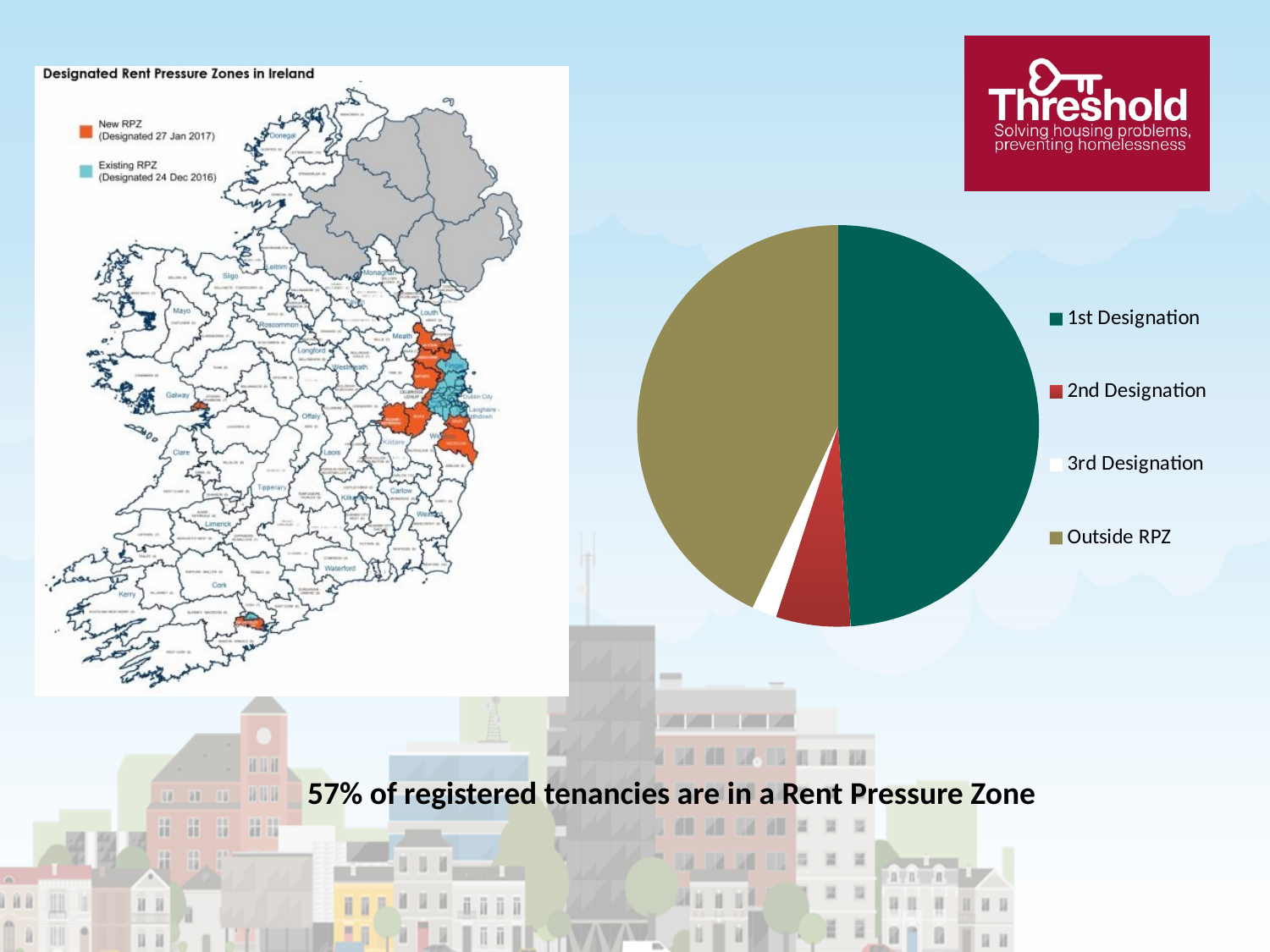
In the pie chart, which is larger: 1st Designation or 2nd Designation? 1st Designation How many slices does the pie chart have? 4 What colour is the 1st Designation slice in the pie chart? dark green Which category has the smallest slice in the pie chart? 3rd Designation In the pie chart, which is larger: Outside RPZ or 2nd Designation? Outside RPZ Which category has the largest slice in the pie chart? 1st Designation Which legend entry in the pie chart is shown in red? 2nd Designation How many entries does the pie chart's legend list? 4 What kind of chart is shown on the right of the slide? pie chart In the pie chart, which is larger: 2nd Designation or 3rd Designation? 2nd Designation